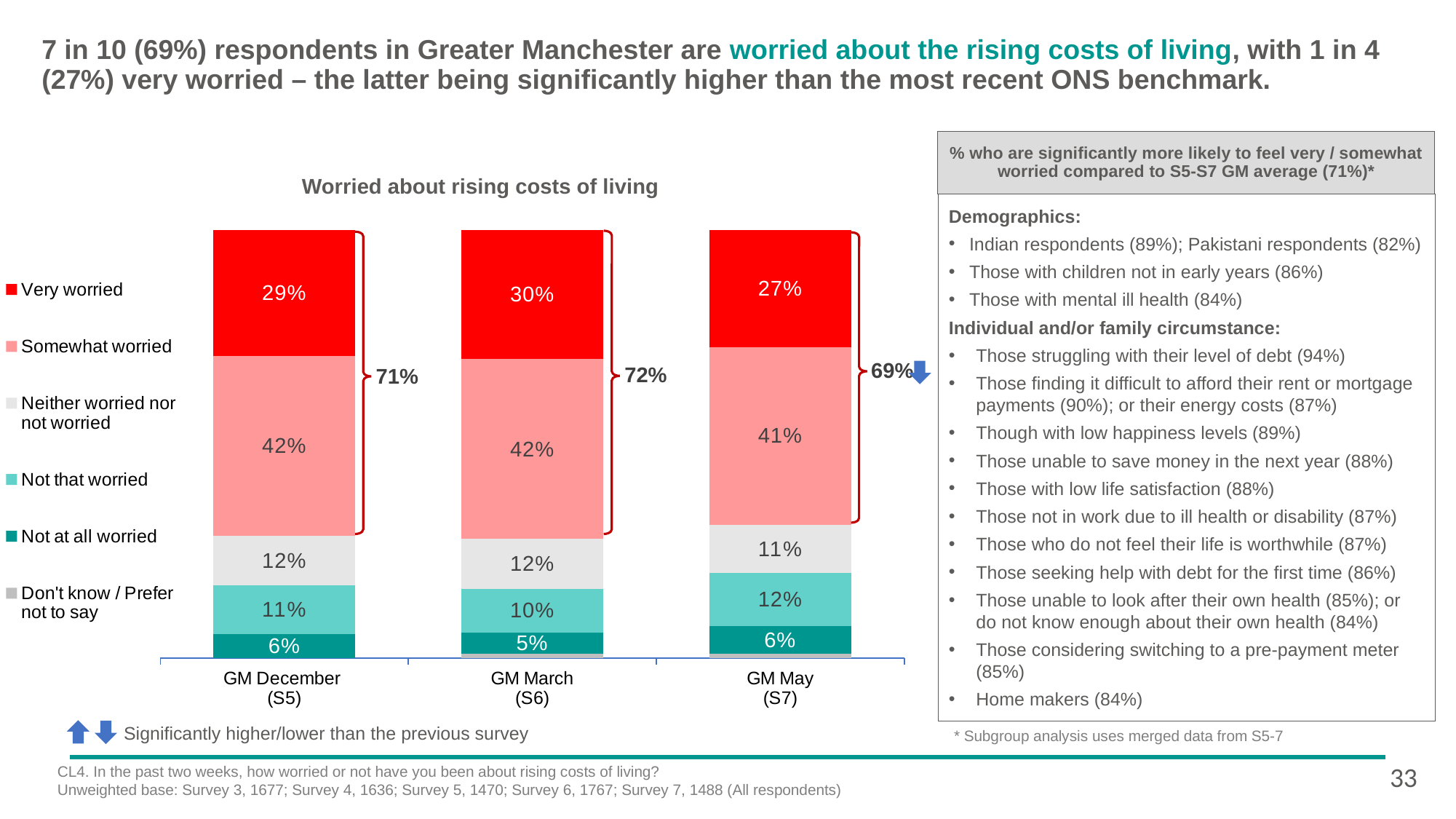
In which survey wave was the 'Not that worried' share lowest? GM March (S6) What kind of chart is shown on the slide? Stacked bar chart In which survey wave was the 'Very worried' share highest? GM March (S6) Is the 'Not that worried' share larger in GM May (S7) or in GM March (S6)? GM May (S7) What is the difference between the 'Very worried' share in GM March (S6) and GM May (S7)? 3 percentage points What percentage of respondents were 'Not at all worried' in GM December (S5)? 6% How many series does the chart legend list? 6 What is the title of the chart? Worried about rising costs of living How many survey waves (categories) are shown on the x axis of the chart? 3 What is the combined 'Very worried' and 'Somewhat worried' share shown for GM May (S7)? 69% What percentage of respondents were 'Somewhat worried' in GM May (S7)? 41% What percentage of respondents were 'Very worried' in GM March (S6)? 30%